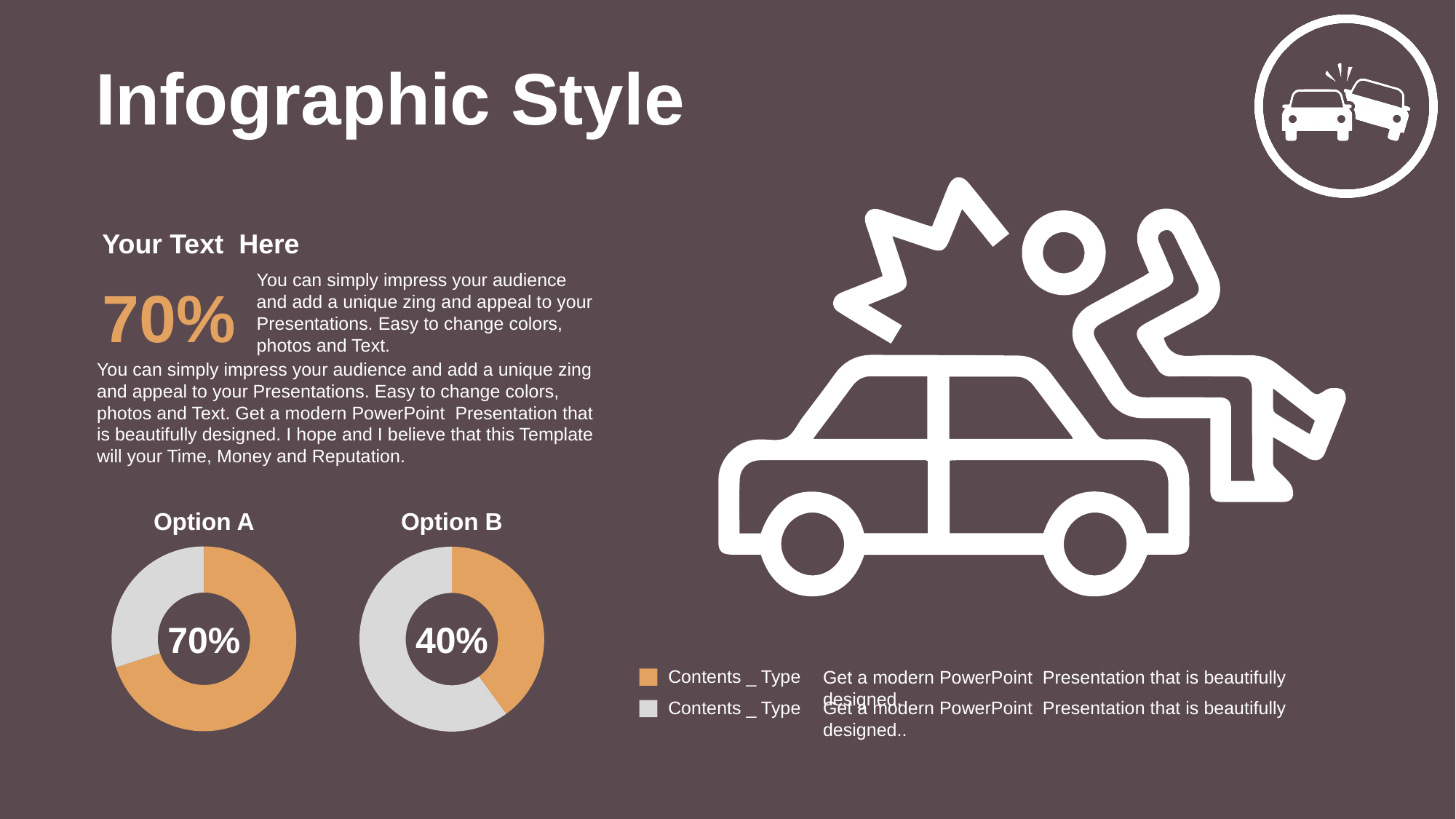
Is the value shown for Option A greater or less than 50%? greater In the Option B chart, what share of the ring is orange? 40% In the Option A chart, what share of the ring is orange? 70% How many entries does the legend at the bottom right list? 2 Is the value shown for Option B greater or less than 50%? less What kind of chart is used for Option A? Donut chart How many donut charts are on the slide? 2 What value is shown in the centre of the Option B chart? 40% What is the difference between the percentages shown for Option A and Option B? 30% What colour is the larger segment in the Option B chart? Grey Which option chart shows the higher percentage, Option A or Option B? Option A What value is shown in the centre of the Option A chart? 70%